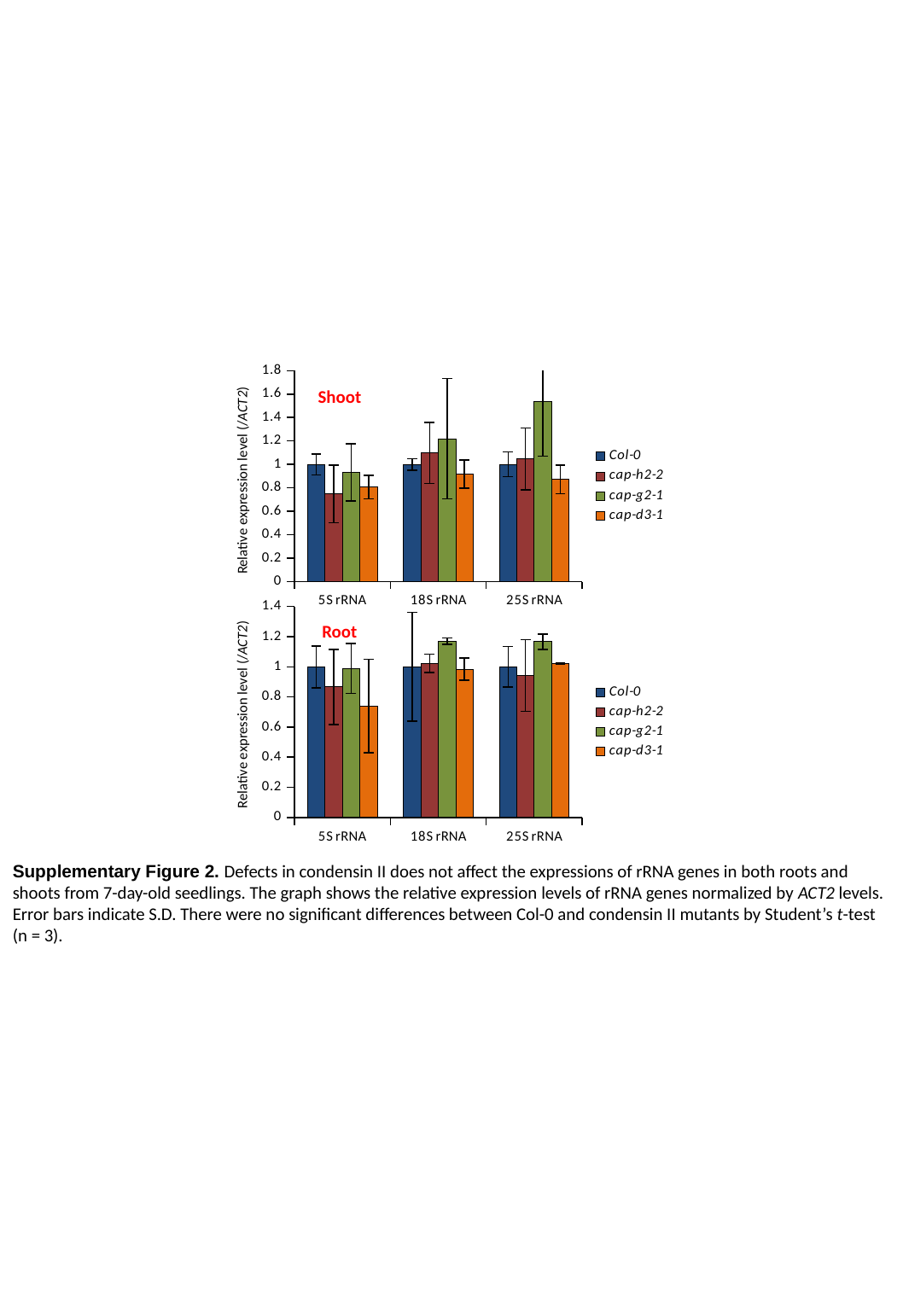
In the Shoot chart, which is larger for 25S rRNA: cap-g2-1 or cap-d3-1? cap-g2-1 In the Shoot chart, which series has the lowest bar for 5S rRNA? cap-h2-2 In the Root chart, is the value for cap-d3-1 at 5S rRNA greater or less than 0.8? less In the Shoot chart, is the value for cap-g2-1 at 25S rRNA greater or less than 1.4? greater In the Shoot chart, what is the relative expression level of Col-0 for 5S rRNA? 1 What kind of chart is the Shoot chart? bar chart In the Root chart, which series has the lowest bar for 5S rRNA? cap-d3-1 In the Root chart, which colour represents cap-d3-1 in the legend? orange How many series does the legend of the Root chart list? 4 In the Root chart, what is the relative expression level of Col-0 for 25S rRNA? 1 In the Shoot chart, which series has the highest bar for 25S rRNA? cap-g2-1 How many rRNA categories are shown on the x axis of the Shoot chart? 3